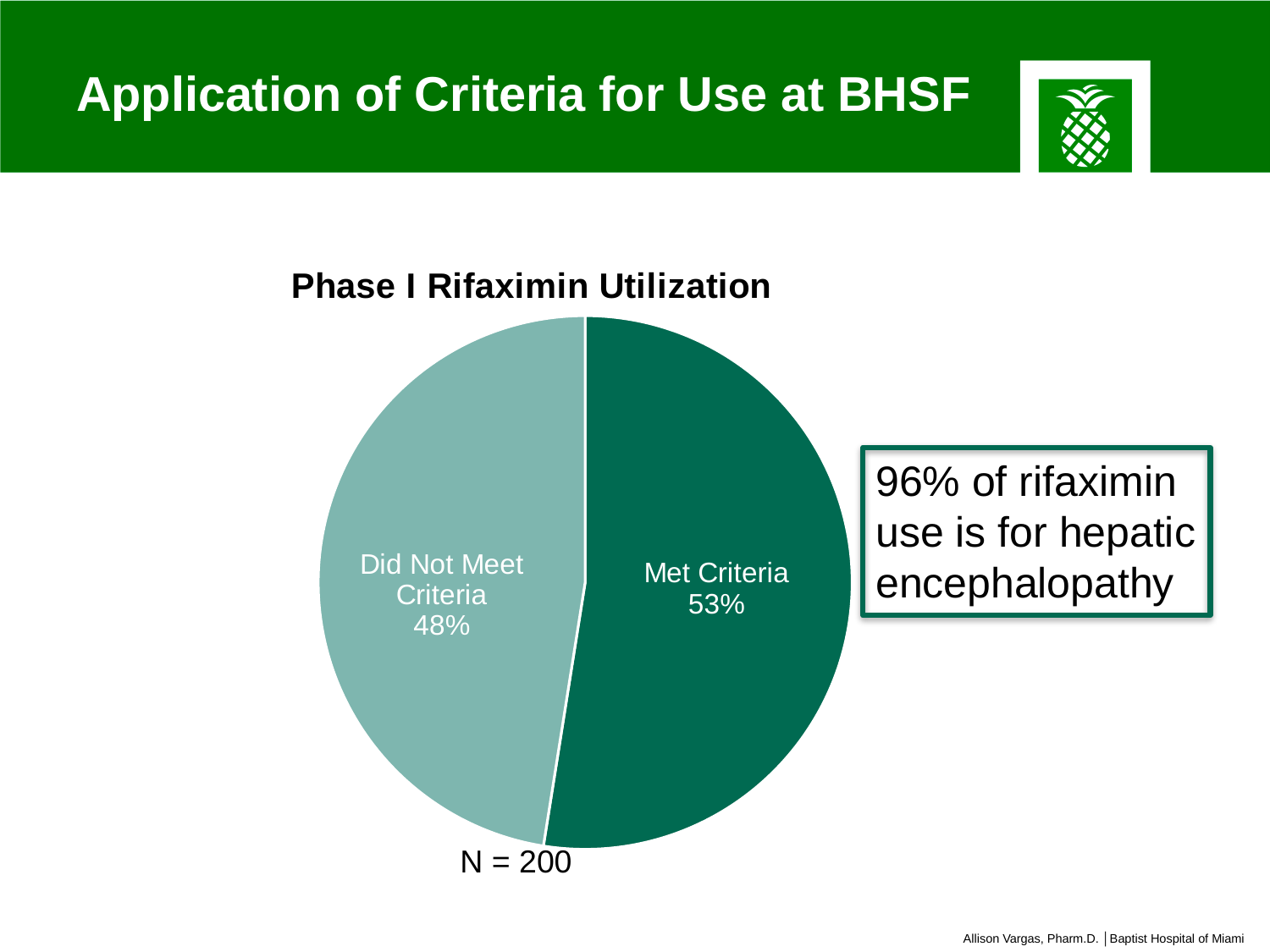
What is the sample size (N) shown below the chart? N = 200 Which category has the largest share of the pie? Met Criteria What is the title of the chart? Phase I Rifaximin Utilization What percentage of cases Met Criteria? 53% Which slice is larger, Met Criteria or Did Not Meet Criteria? Met Criteria Which category has the smallest share of the pie? Did Not Meet Criteria What type of chart is shown on the slide? pie chart What percentage of cases Did Not Meet Criteria? 48% How many slices does the pie chart have? 2 What share of the pie does the Did Not Meet Criteria slice represent? 48% What is the difference in percentage points between Met Criteria and Did Not Meet Criteria? 5